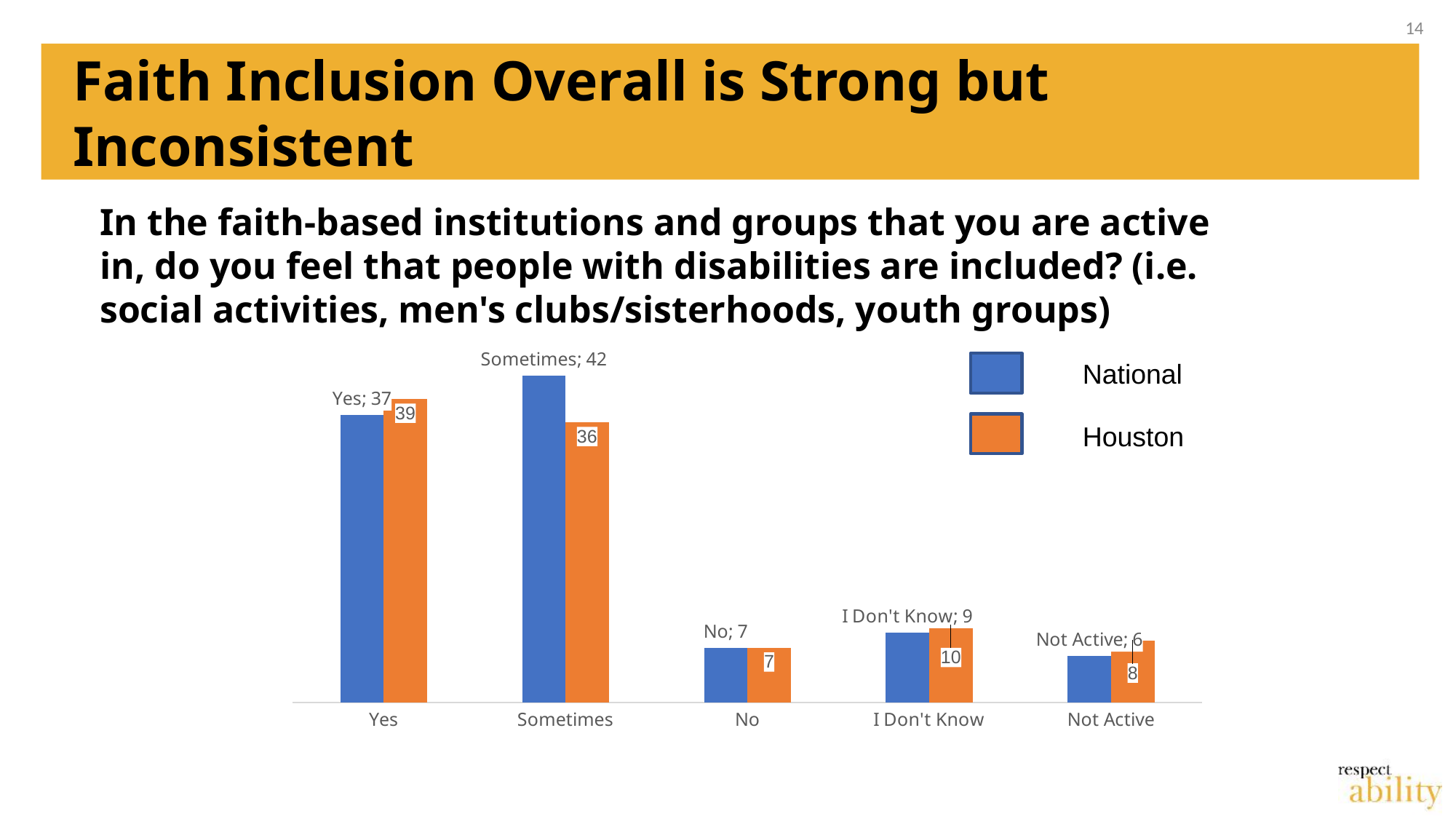
What kind of chart is shown on the slide? Bar chart Which is larger for Yes, the National value or the Houston value? Houston What is the National value for Sometimes? 42 How many series does the legend list? 2 Which category has the highest National value? Sometimes What is the National value for Not Active? 6 Which category has the highest Houston value? Yes What is the Houston value for I Don't Know? 10 Which category has the lowest National value? Not Active How many categories are shown on the x axis? 5 What is the difference between the National and Houston values for Sometimes? 6 What is the Houston value for Yes? 39